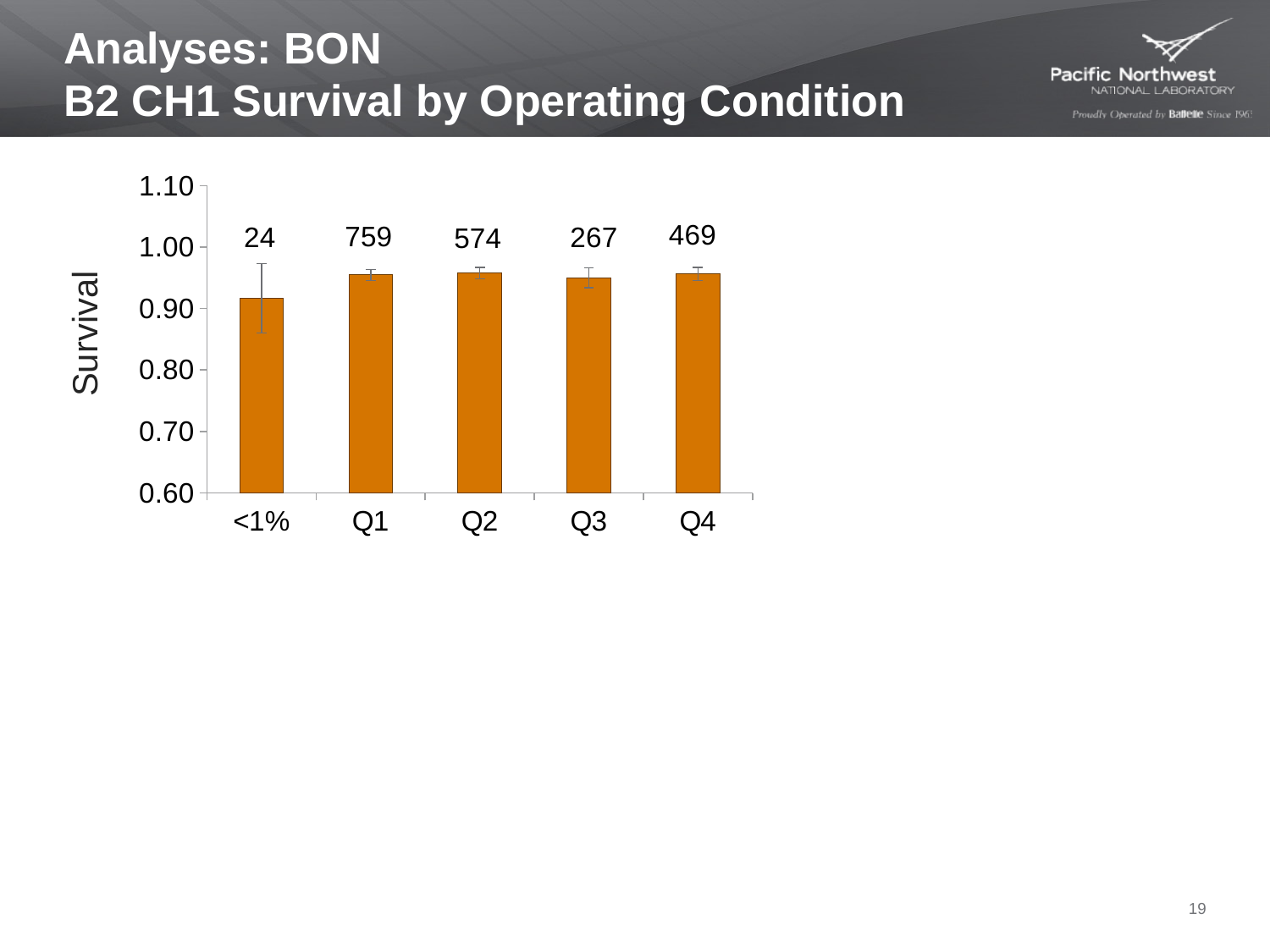
Which has the larger survival value, Q3 or <1%? Q3 Which category has the lowest survival value in the chart? <1% Is the survival value for <1% greater or less than 0.90? greater How many categories are shown on the x axis of the chart? 5 Is the survival value for Q1 greater or less than 1.00? less Is the survival value for Q4 greater or less than 0.80? greater What number is printed above the <1% bar? 24 Which has the larger survival value, <1% or Q1? Q1 What is the label on the y axis of the chart? Survival What number is printed above the Q1 bar? 759 What kind of chart is shown on the slide? bar chart